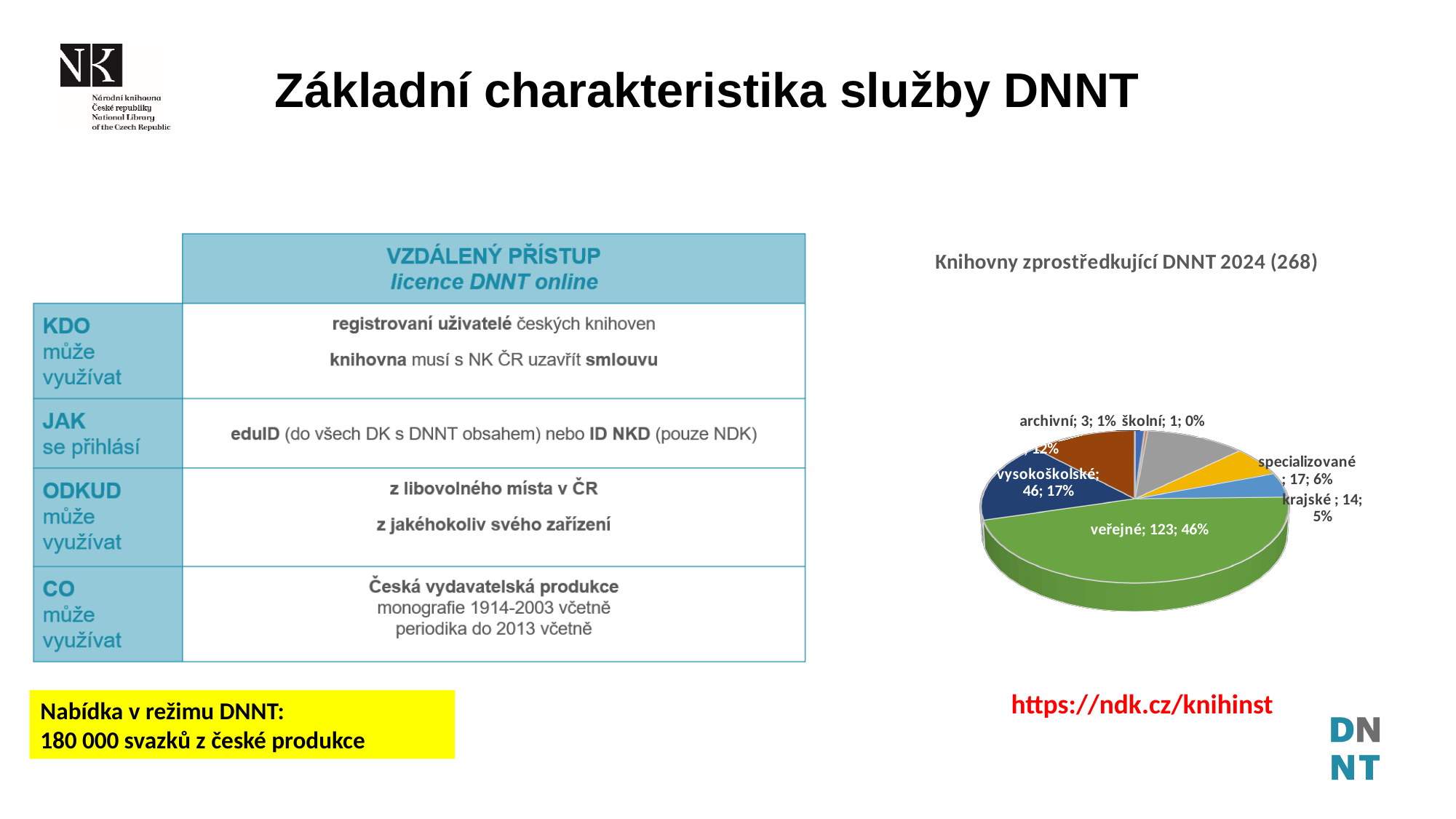
What is the title of the pie chart? Knihovny zprostředkující DNNT 2024 (268) What value is shown for the 'specializované' slice? 17 What kind of chart is shown on the slide? pie chart Which category has the largest slice of the pie chart? veřejné What percentage is shown for the 'vysokoškolské' slice? 17% What share of the pie does the 'veřejné' slice represent? 46% How many libraries are in the 'vysokoškolské' slice? 46 What percentage is shown for the 'archivní' slice? 1% What is the difference between the 'specializované' and 'krajské' values? 3 How many libraries are in the 'veřejné' slice of the pie chart? 123 What value is shown for the 'krajské' slice? 14 Which labelled category has the smallest slice of the pie chart? školní